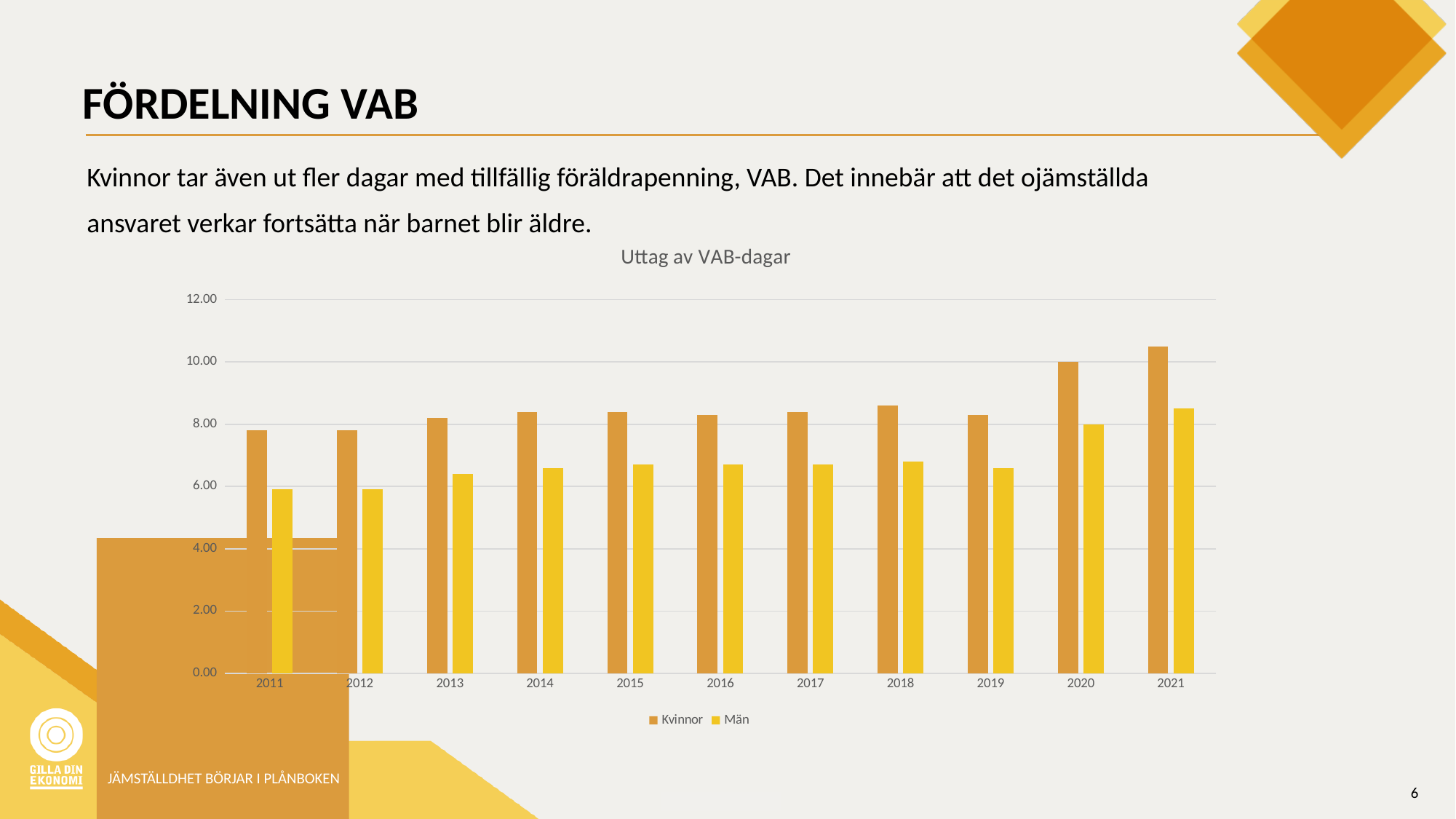
In which year is the value for Män highest? 2021 What is the title of the chart? Uttag av VAB-dagar Is the value for Män in 2021 greater or less than 8.00? greater How many years are shown on the x axis of the chart? 11 Which series is shown in the darker orange colour in the chart? Kvinnor Is the value for Kvinnor in 2021 greater or less than 10.00? greater In 2021, which is larger, the value for Kvinnor or the value for Män? Kvinnor Do the values for Män generally rise or fall from 2011 to 2021? rise What type of chart is shown on the slide? bar chart In which year is the value for Kvinnor highest? 2021 How many series does the chart legend list? 2